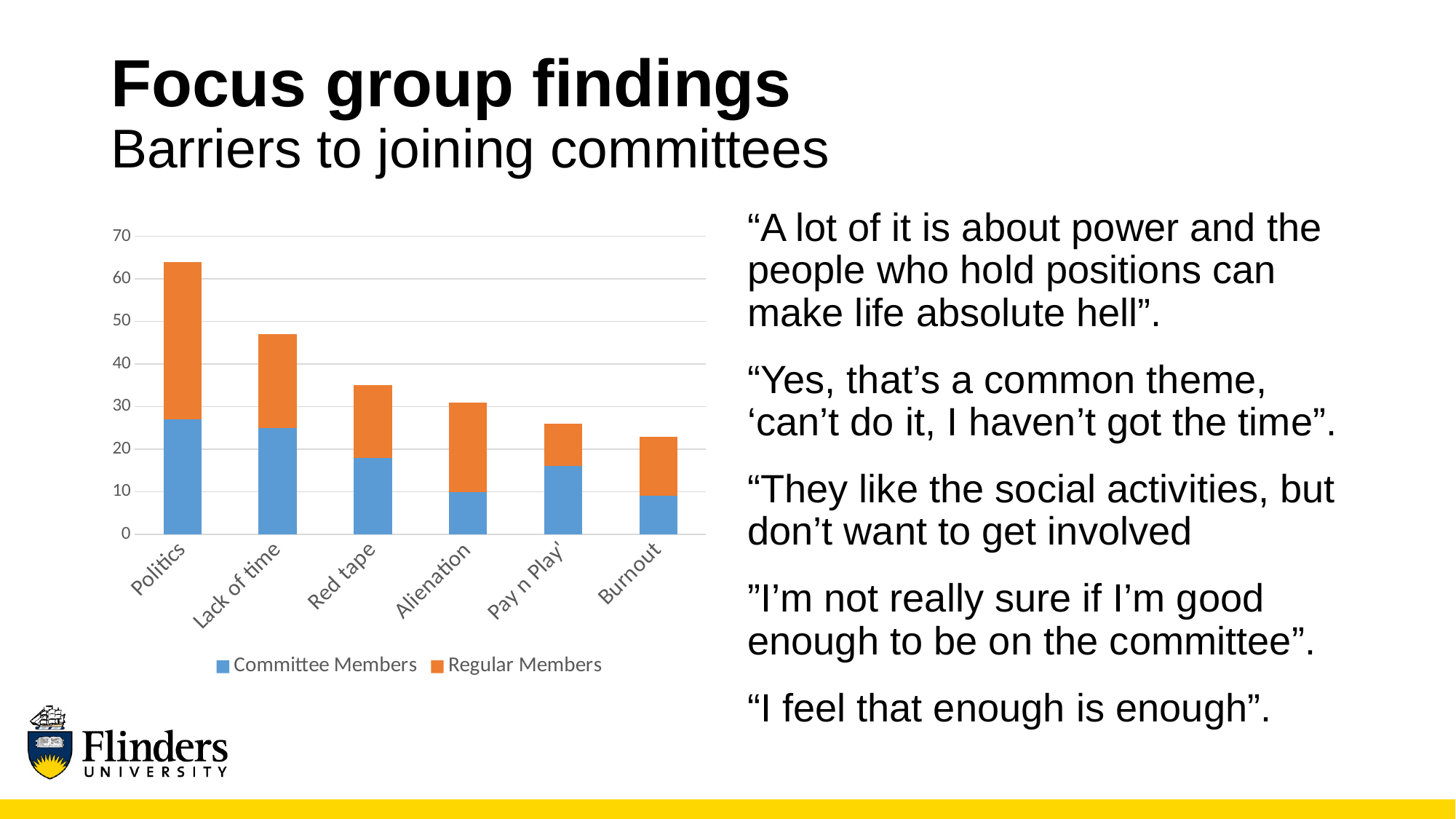
What kind of chart is shown on the slide? stacked bar chart Which series is shown in orange in the chart legend? Regular Members Is the total stacked value for Lack of time greater or less than 40? greater How many categories are shown on the x axis of the chart? 6 Is the total stacked value for Politics greater or less than 60? greater How many series does the chart legend list? 2 Is the Committee Members value for Alienation greater or less than 20? less Which has the larger total stacked bar, Politics or Lack of time? Politics Do the total stacked bar heights rise or fall moving from left to right along the x axis? fall Which category has the tallest stacked bar in the chart? Politics Which category has the shortest stacked bar in the chart? Burnout